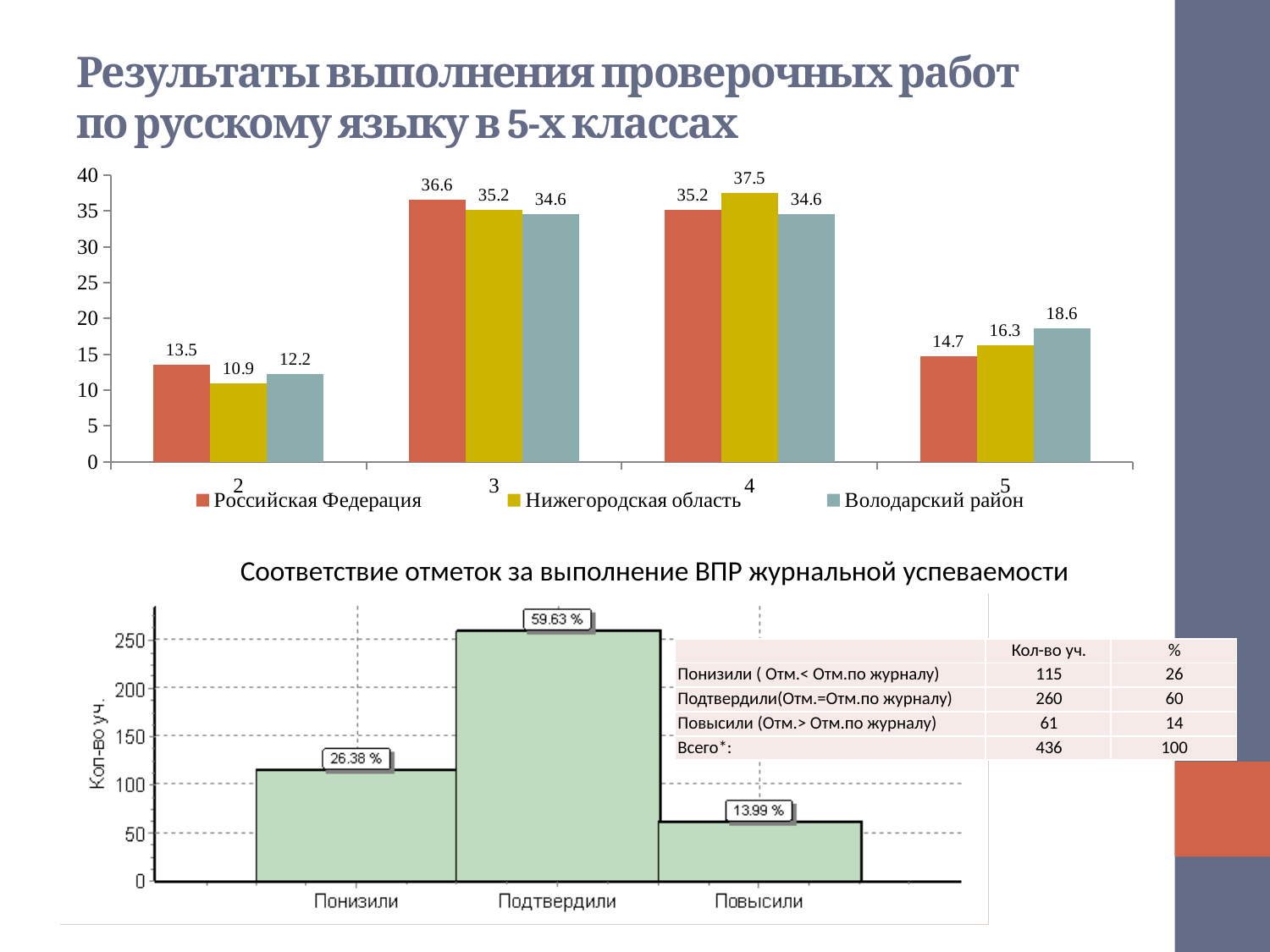
In the top chart, what is the difference between the Российская Федерация and Володарский район values for category 5? 3.9 In the top chart, what is the value for Нижегородская область for category 2? 10.9 How many series does the legend of the top chart list? 3 In the top chart, which category has the lowest value for Российская Федерация? 2 In the chart titled 'Соответствие отметок за выполнение ВПР журнальной успеваемости', which category has the lowest value? Повысили In the top chart, which is larger for category 4: Нижегородская область or Володарский район? Нижегородская область In the top chart, what is the value for Володарский район for category 5? 18.6 In the top chart, which category has the highest value for Нижегородская область? 4 What type of chart is the bottom chart titled 'Соответствие отметок за выполнение ВПР журнальной успеваемости'? bar chart In the chart titled 'Соответствие отметок за выполнение ВПР журнальной успеваемости', what percentage is shown for Подтвердили? 59.63 % How many categories are shown on the x axis of the top chart? 4 In the top chart, what is the value for Российская Федерация for category 3? 36.6